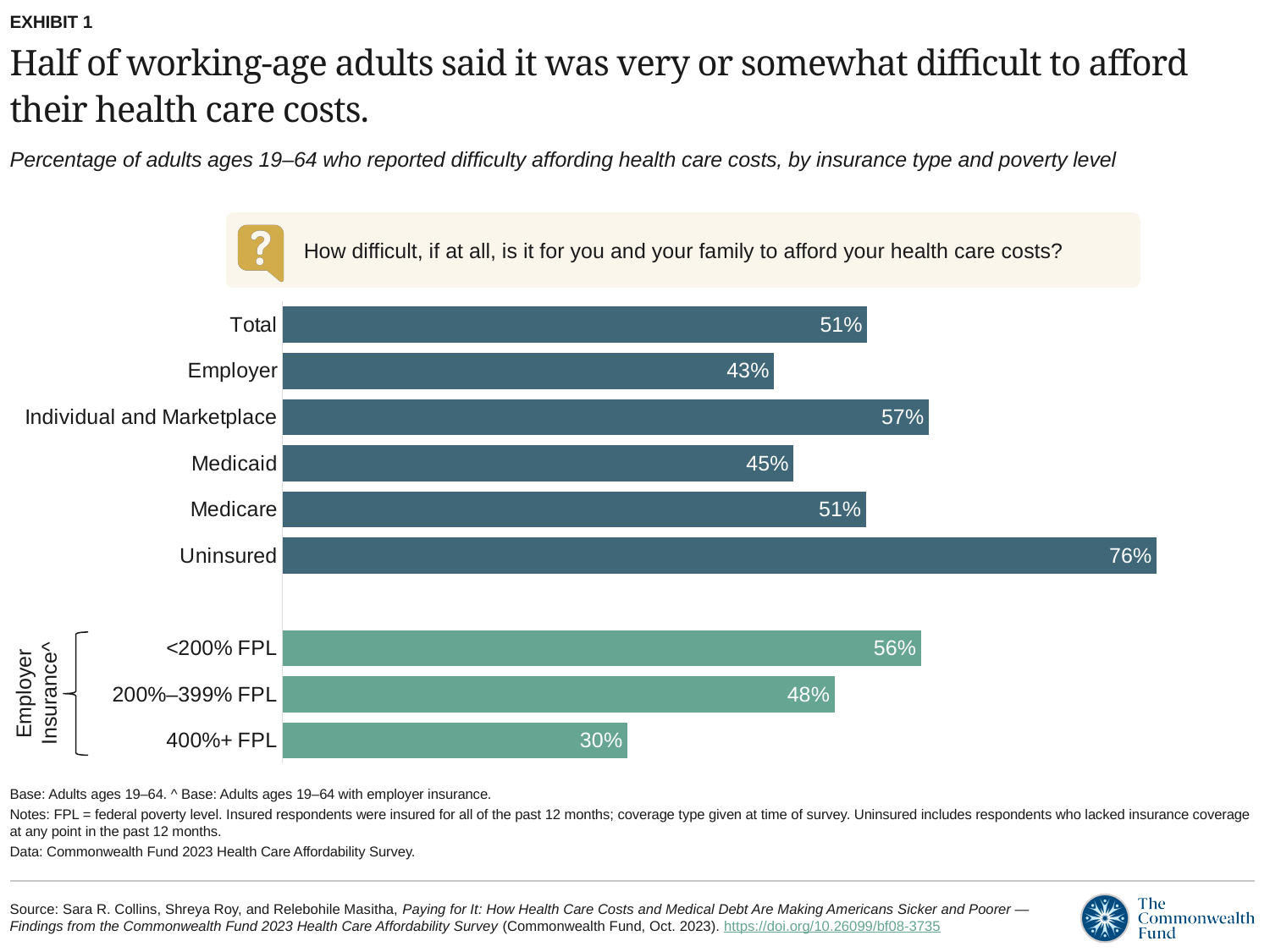
What is the value shown for the Uninsured category? 76% Which category has the lowest percentage on the chart? 400%+ FPL Which is larger, the value for Individual and Marketplace or the value for Medicaid? Individual and Marketplace Among the employer insurance groups, do the values rise or fall as the poverty level increases from <200% FPL to 400%+ FPL? Fall What is the value for the Total category? 51% What percentage is shown for adults with employer insurance at 400%+ FPL? 30% What is the difference between the <200% FPL and 400%+ FPL employer insurance groups? 26 percentage points Which category has the highest percentage reporting difficulty affording health care costs? Uninsured What is the difference in percentage points between the Uninsured and Employer categories? 33 percentage points What type of chart is shown on the slide? Bar chart What percentage of adults with employer insurance reported difficulty affording health care costs? 43% How many bars are shown on the chart? 9